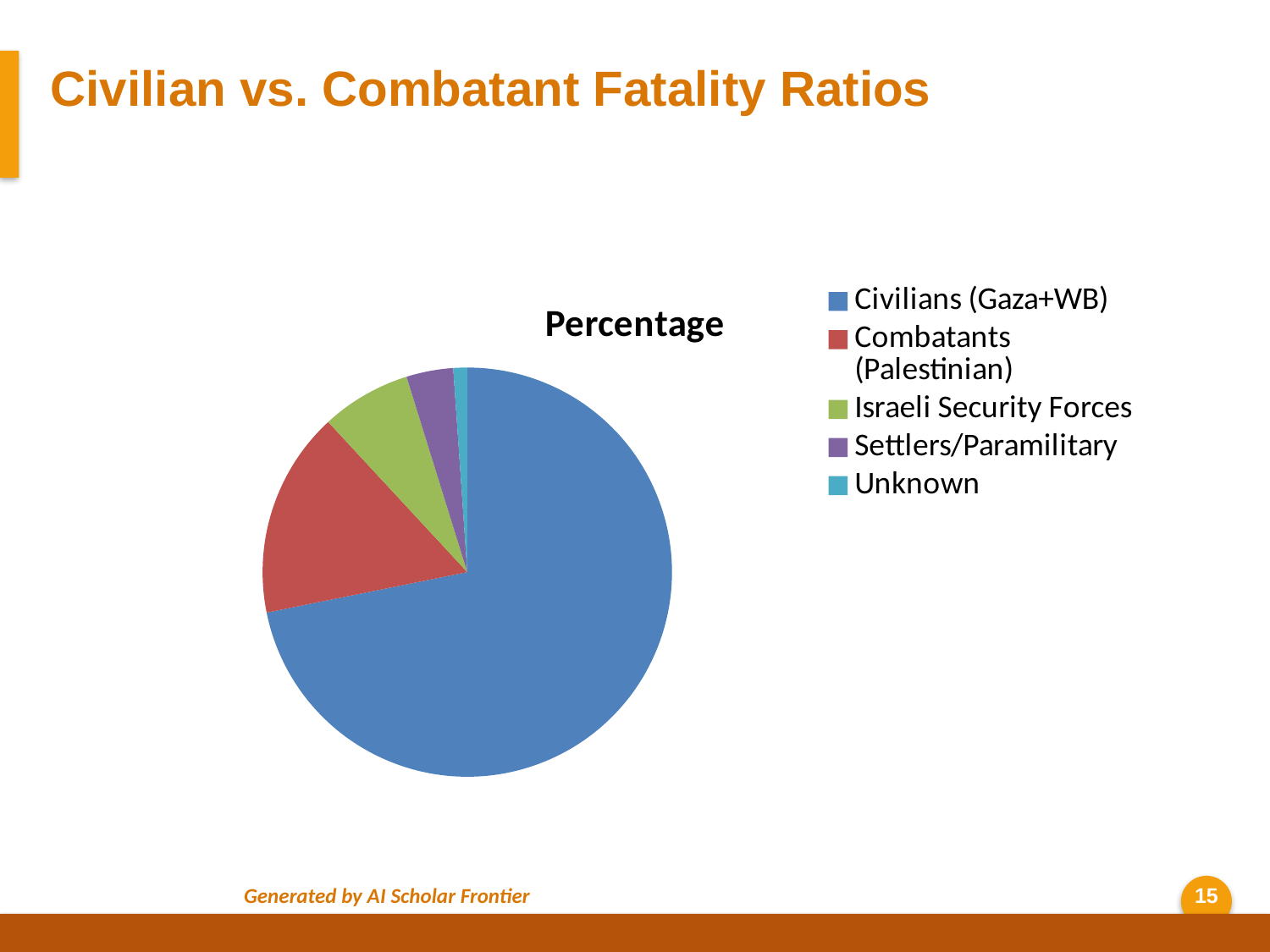
What kind of chart is shown on the slide? Pie chart How many categories does the pie chart have? 5 Which category is shown in blue in the pie chart? Civilians (Gaza+WB) What is the title of the chart? Percentage Which category has the largest slice of the pie? Civilians (Gaza+WB) Which slice is larger: Civilians (Gaza+WB) or Combatants (Palestinian)? Civilians (Gaza+WB) Which slice is larger: Israeli Security Forces or Settlers/Paramilitary? Israeli Security Forces Which slice is larger: Combatants (Palestinian) or Israeli Security Forces? Combatants (Palestinian) Which category has the smallest slice of the pie? Unknown